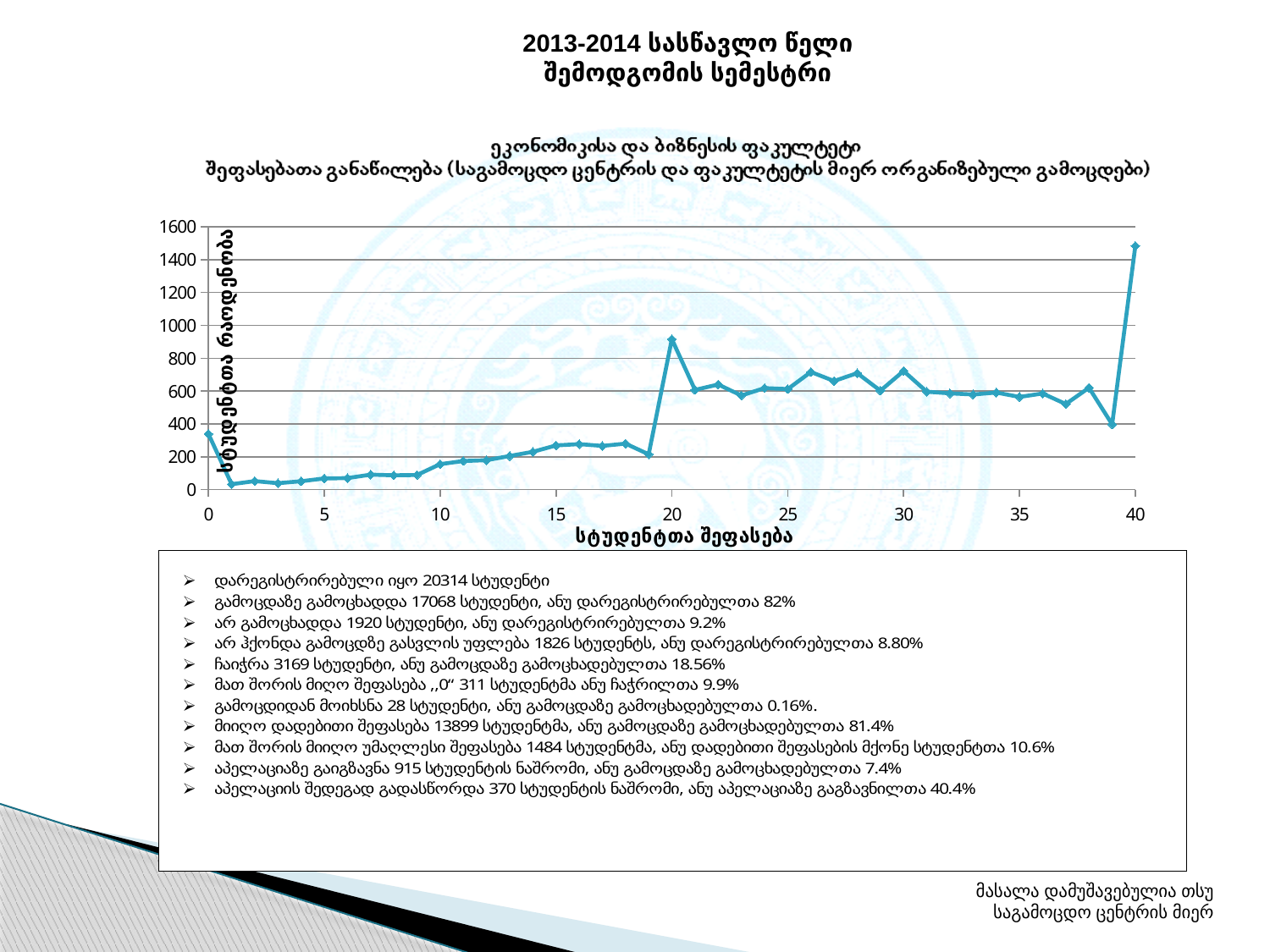
Is the value at grade 25 greater or less than 400? greater Do the values generally rise or fall along the x axis between grade 1 and grade 18? rise What kind of chart is shown on the slide? line chart At which x-axis value (student grade) does the line reach its highest point? 40 Is the value at grade 19 greater or less than 400? less What is the highest tick value shown on the y axis? 1600 Is the value at grade 10 greater or less than 200? less Which has the larger value, grade 0 or grade 10? grade 0 Which has the larger value, grade 20 or grade 30? grade 20